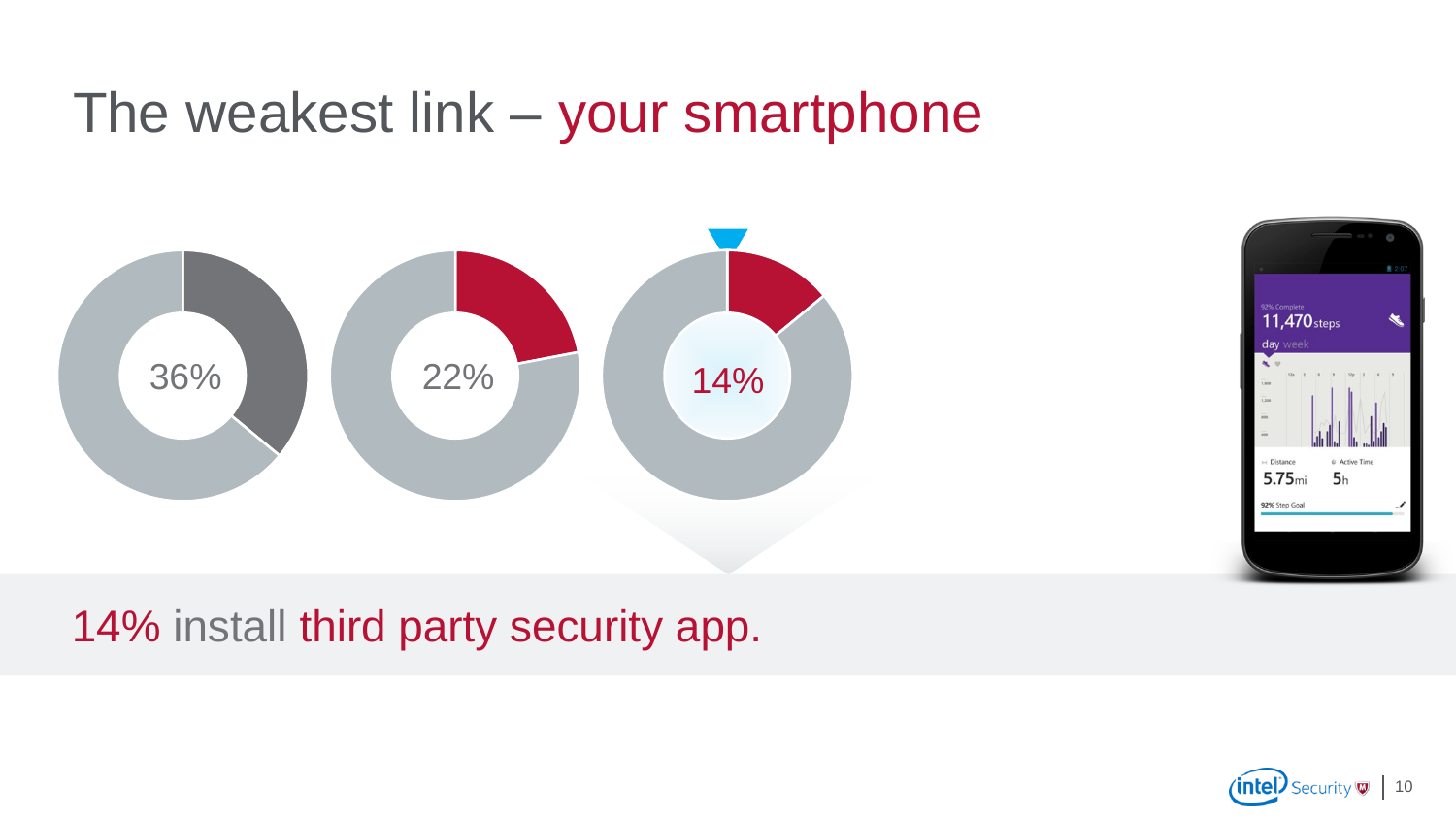
What is the difference between the percentage in the middle donut chart and the percentage in the right donut chart? 8 percentage points Which of the three donut charts shows the highest percentage: left, middle or right? Left (36%) What kind of charts are the three circular graphics on the slide? Donut (pie) charts What is the difference between the percentage in the left donut chart and the percentage in the right donut chart? 22 percentage points How many donut charts are shown on the slide? 3 What value is shown in the centre of the right donut chart, the one highlighted with a blue marker? 14% What colour is the highlighted segment in the middle and right donut charts? Red Which of the three donut charts shows the lowest percentage: left, middle or right? Right (14%) Which is larger, the value in the middle donut chart or the value in the right donut chart? The middle donut chart (22%) According to the slide, what percentage install a third party security app? 14% What value is shown in the centre of the left donut chart? 36% What value is shown in the centre of the middle donut chart? 22%